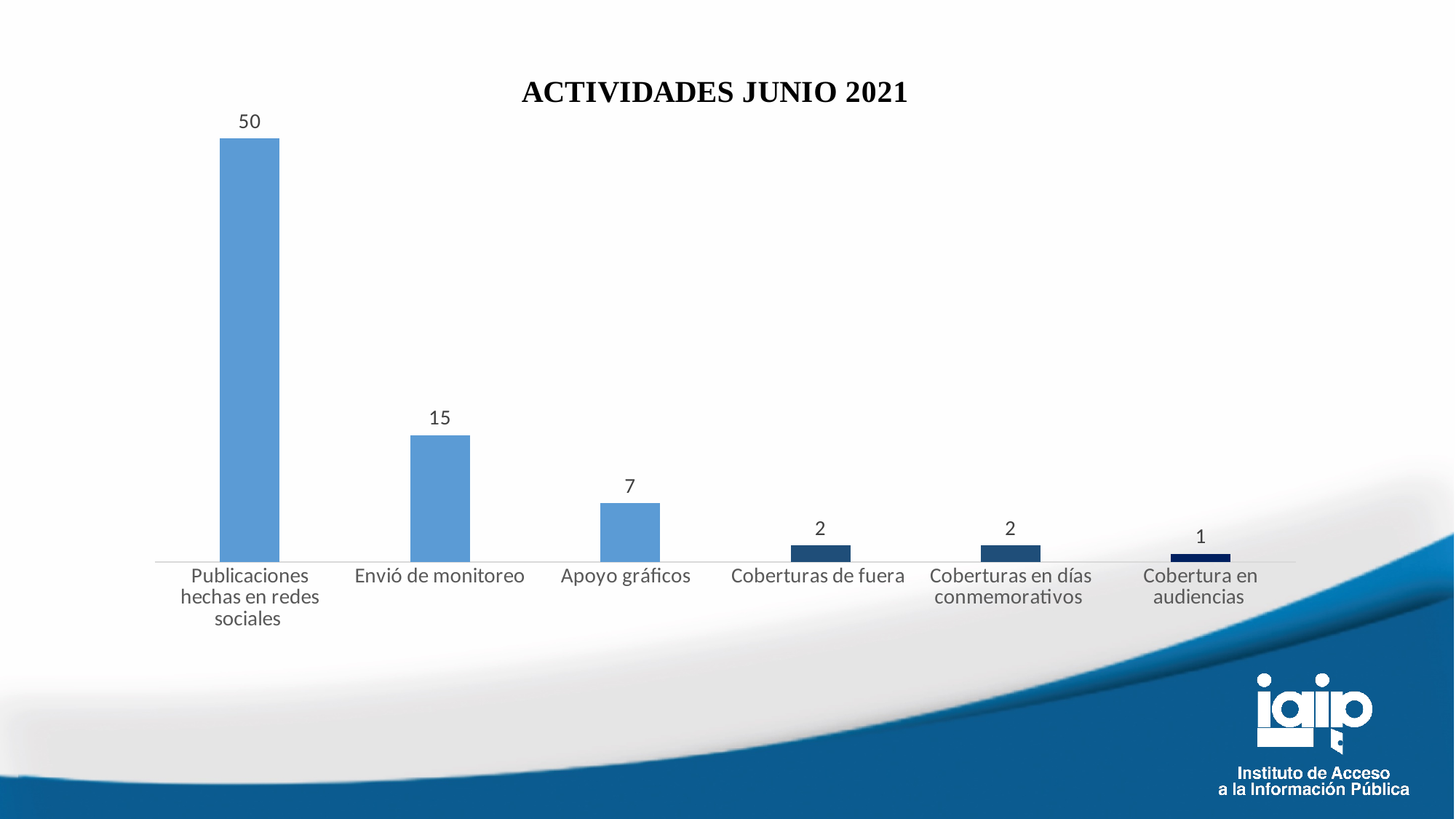
What is the title of the chart? ACTIVIDADES JUNIO 2021 What is the value for Apoyo gráficos? 7 What is the difference between the values for Publicaciones hechas en redes sociales and Envió de monitoreo? 35 How many categories are shown in the chart? 6 What is the difference between the values for Apoyo gráficos and Coberturas de fuera? 5 What kind of chart is shown on the slide? Bar chart Which category has the highest value? Publicaciones hechas en redes sociales What is the value for Cobertura en audiencias? 1 Which category has the lowest value? Cobertura en audiencias What is the value for Envió de monitoreo? 15 Which is larger, the value for Envió de monitoreo or the value for Apoyo gráficos? Envió de monitoreo What is the value for Publicaciones hechas en redes sociales? 50